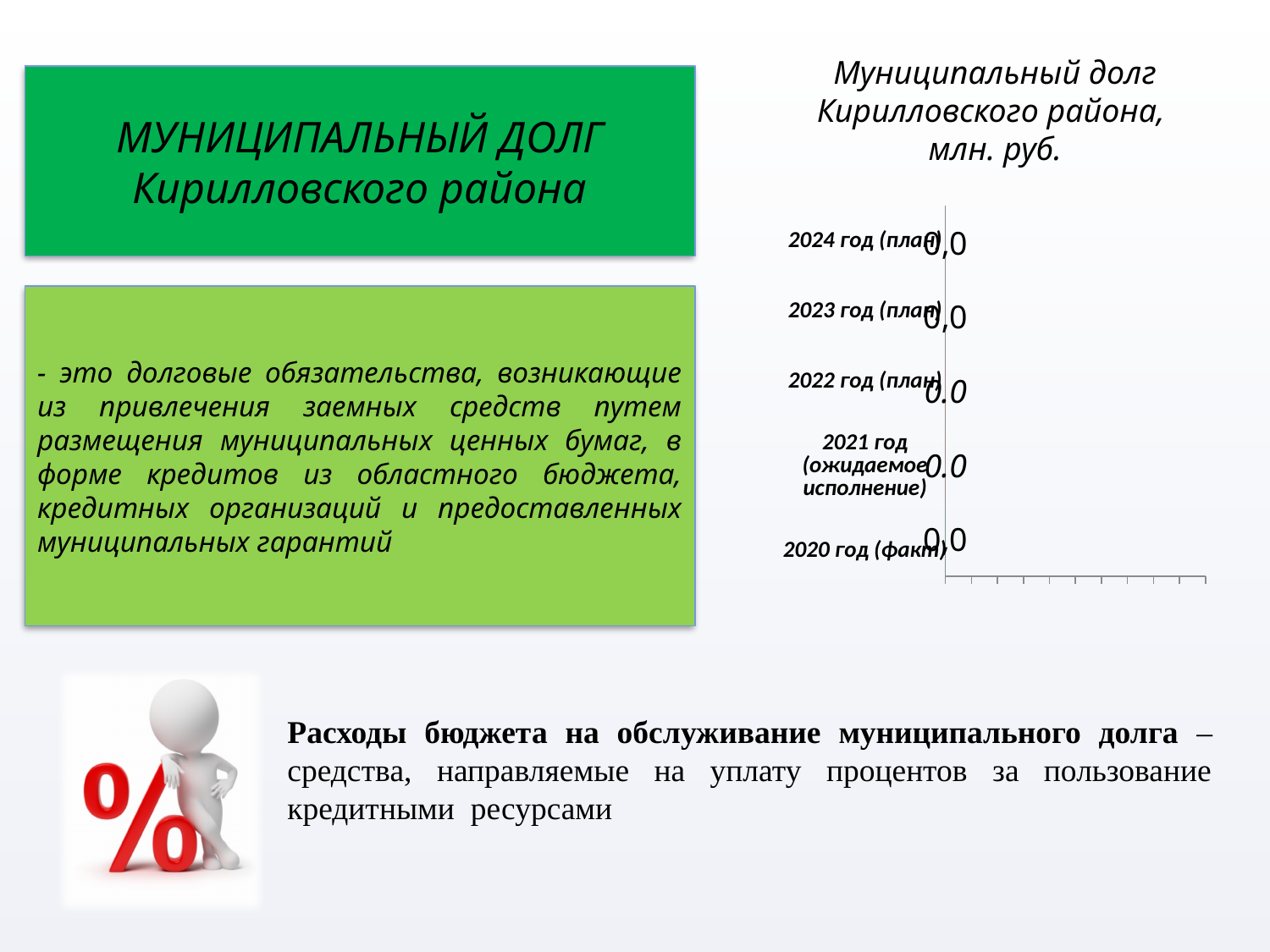
How many categories are shown on the chart? 5 What is the value for 2022 год (план)? 0.0 Do the values change across the years shown on the chart? No, they stay the same What is the value for 2021 год (ожидаемое исполнение)? 0.0 In what units are the chart values given? млн. руб. What is the difference between the values for 2024 год (план) and 2020 год (факт)? 0,0 What is the value for 2024 год (план)? 0,0 What is the value for 2020 год (факт)? 0,0 What is the value for 2023 год (план)? 0,0 What is the title of the chart? Муниципальный долг Кирилловского района, млн. руб. What kind of chart is shown on the slide? bar chart